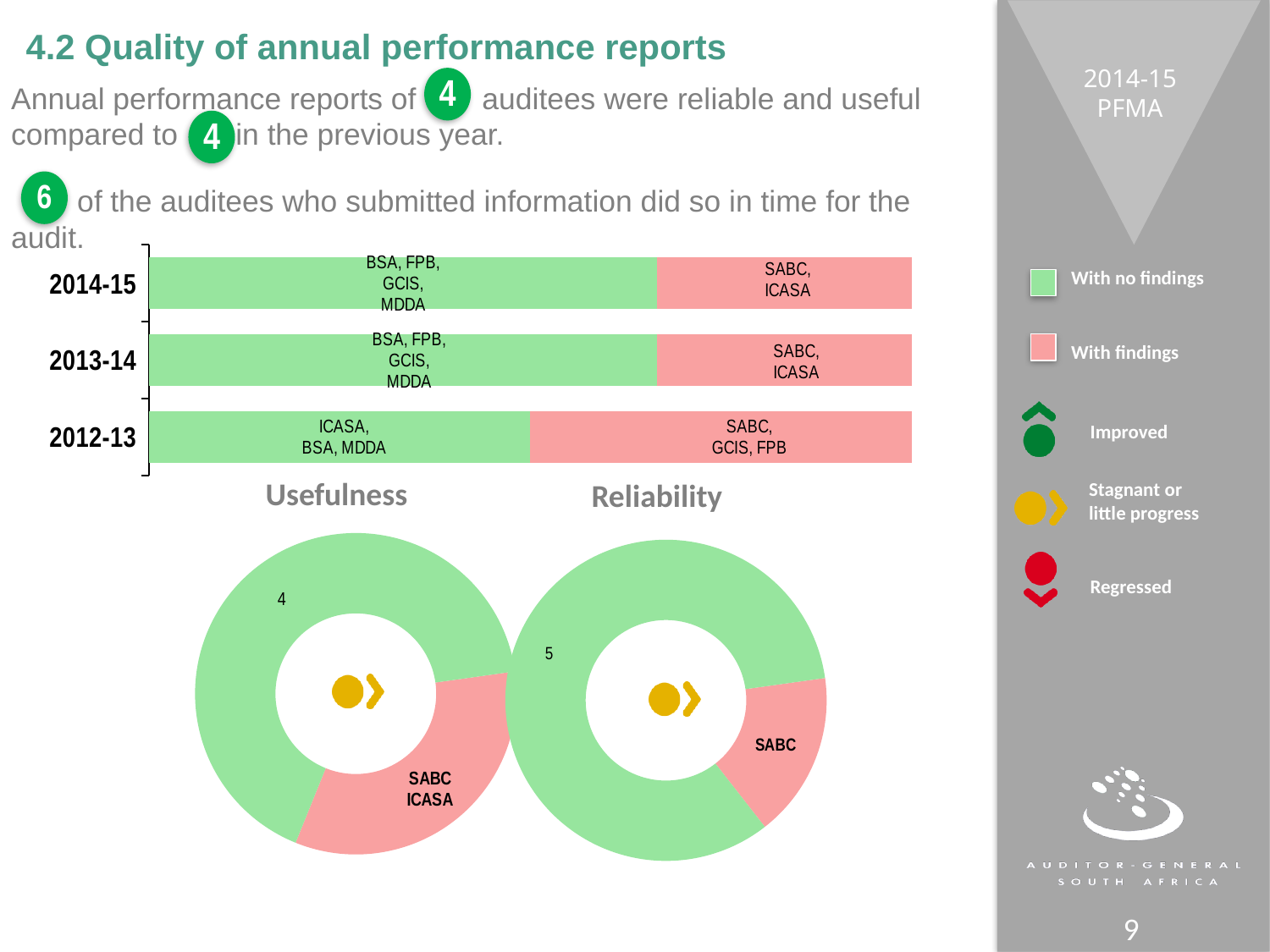
In the Usefulness donut chart, what value is shown for the 'With no findings' segment? 4 In the Usefulness donut chart, which auditees are labelled in the 'With findings' segment? SABC, ICASA What kind of chart is the chart showing the years 2014-15, 2013-14 and 2012-13? Stacked bar chart In the stacked bar chart, which auditees are listed in the 'With findings' segment for 2012-13? SABC, GCIS, FPB In the Reliability donut chart, what value is shown for the 'With no findings' segment? 5 How many years (categories) are shown in the stacked bar chart? 3 How many series does the legend on the right list for the bar chart? 2 In the stacked bar chart, for 2014-15, is the 'With no findings' segment or the 'With findings' segment larger? With no findings In the stacked bar chart, from 2012-13 to 2013-14, did the 'With no findings' segment get larger or smaller? Larger In the Reliability donut chart, which auditee is labelled in the 'With findings' segment? SABC In the stacked bar chart, which auditees are listed in the 'With no findings' segment for 2014-15? BSA, FPB, GCIS, MDDA Which donut chart has the larger 'With no findings' value, Usefulness or Reliability? Reliability